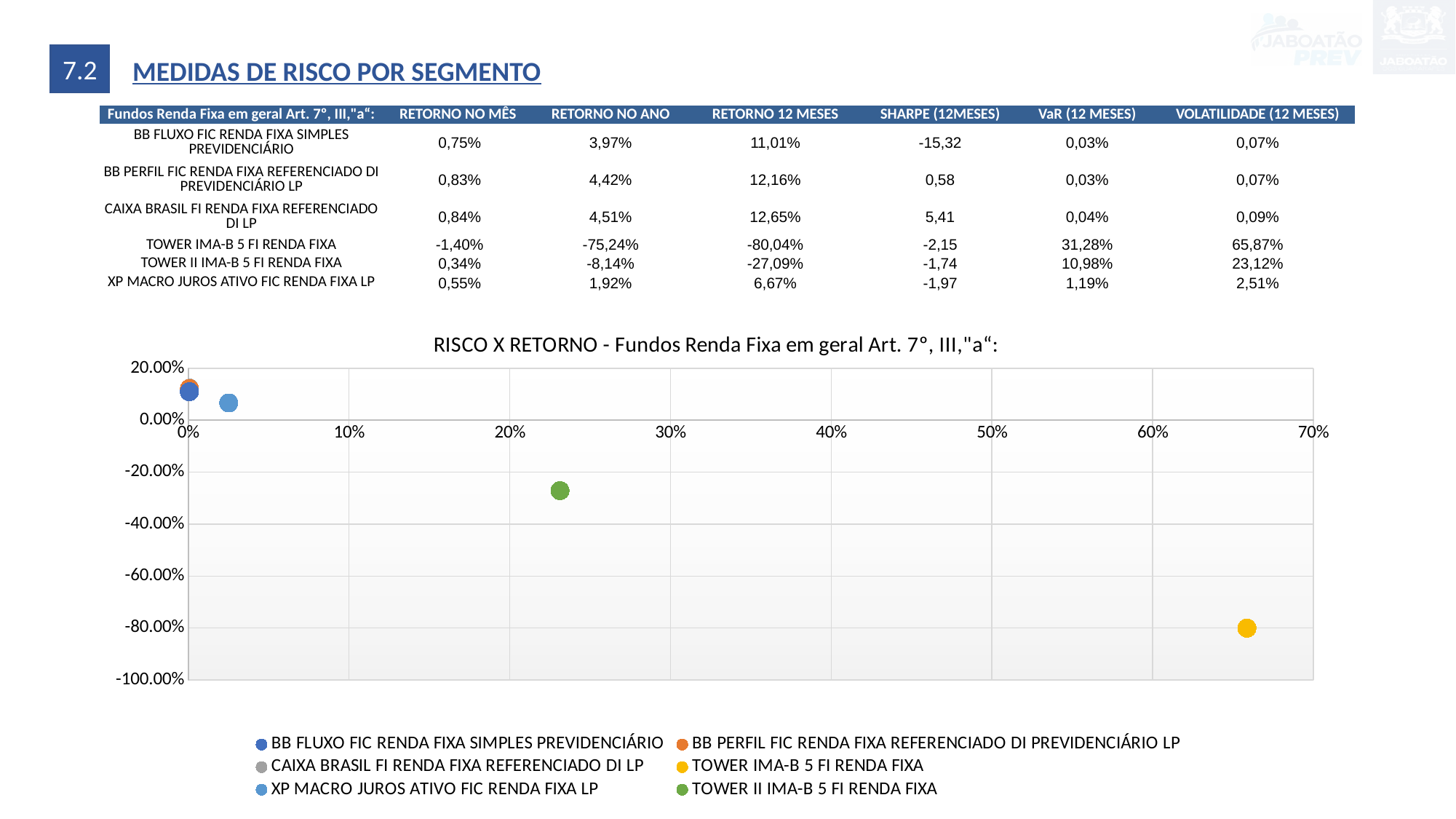
According to the table above the chart, what is the VOLATILIDADE (12 MESES) for TOWER II IMA-B 5 FI RENDA FIXA? 23,12% What kind of chart is shown on the slide? scatter chart In the RISCO X RETORNO chart, is the vertical-axis value for TOWER IMA-B 5 FI RENDA FIXA greater or less than -60.00%? less In the RISCO X RETORNO chart, is the horizontal-axis value for TOWER II IMA-B 5 FI RENDA FIXA greater or less than 20%? greater How many series does the legend of the RISCO X RETORNO chart list? 6 In the RISCO X RETORNO chart, which series has the lowest vertical-axis value? TOWER IMA-B 5 FI RENDA FIXA According to the table above the chart, what is the RETORNO 12 MESES for TOWER IMA-B 5 FI RENDA FIXA? -80,04% In the RISCO X RETORNO chart, is the vertical-axis value for TOWER II IMA-B 5 FI RENDA FIXA greater or less than -20.00%? less In the RISCO X RETORNO chart, which series is plotted furthest to the right on the horizontal axis? TOWER IMA-B 5 FI RENDA FIXA In the RISCO X RETORNO chart, which is plotted higher on the vertical axis: XP MACRO JUROS ATIVO FIC RENDA FIXA LP or TOWER II IMA-B 5 FI RENDA FIXA? XP MACRO JUROS ATIVO FIC RENDA FIXA LP What is the title of the chart on the slide? RISCO X RETORNO - Fundos Renda Fixa em geral Art. 7°, III,"a":